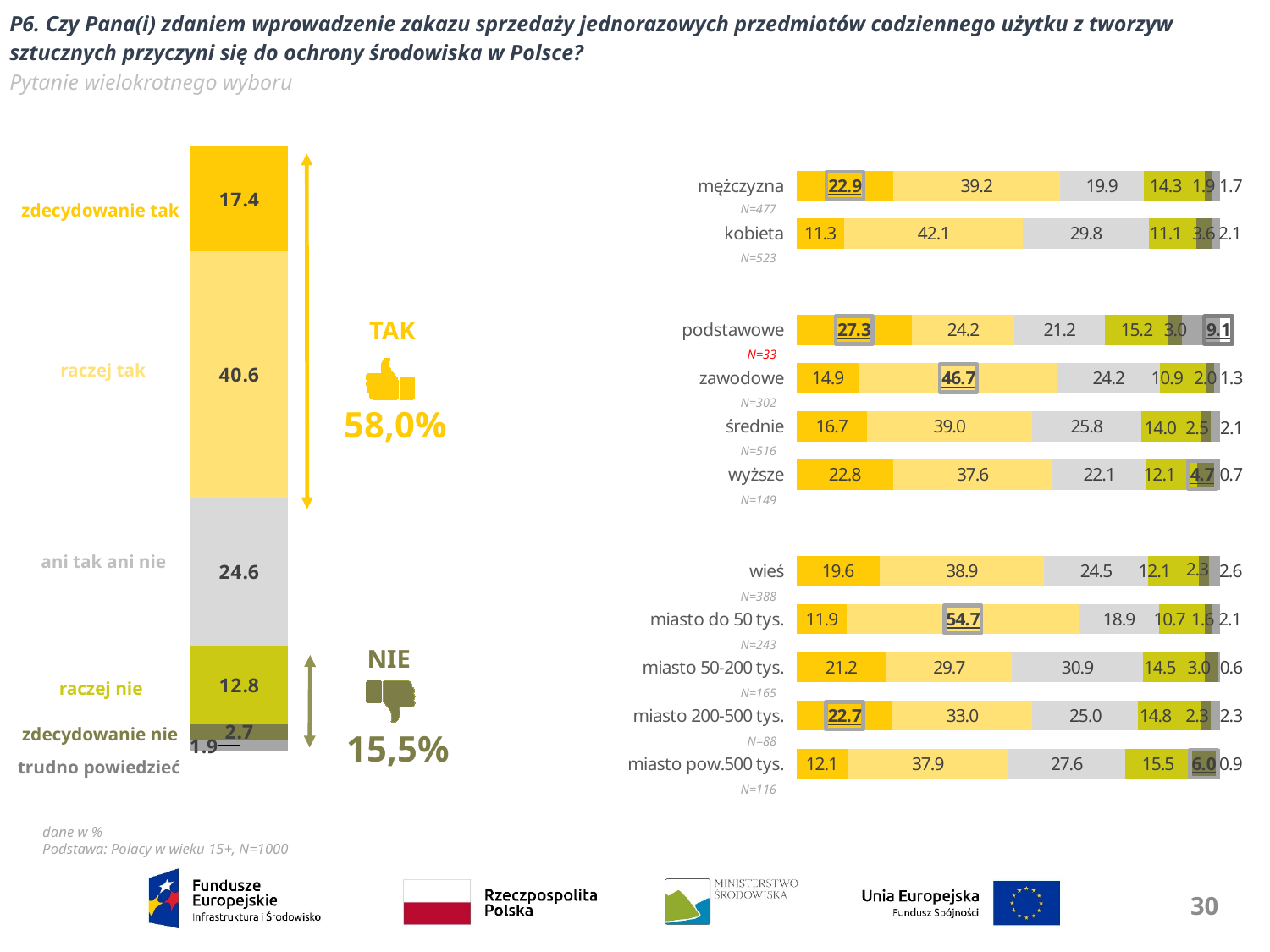
In the right chart of demographic groups, is the first (dark yellow) segment larger for 'mężczyzna' or 'kobieta'? mężczyzna In the right chart of demographic groups, what is the value of the first (dark yellow) segment for 'mężczyzna'? 22.9 In the left stacked bar chart, what is the difference between 'raczej tak' and 'zdecydowanie tak'? 23.2 In the left stacked bar chart, what combined percentage is shown next to the 'TAK' label? 58,0% How many demographic groups are shown in the right chart? 11 In the left stacked bar chart, what is the value for 'raczej tak'? 40.6 In the right chart of demographic groups, what is the value of the second (light yellow) segment for 'miasto do 50 tys.'? 54.7 In the right chart of demographic groups, which group has the highest value in the first (dark yellow) segment? podstawowe In the left stacked bar chart, which category has the highest value? raczej tak In the right chart of demographic groups, what is the difference between the grey (third) segment for 'kobieta' and for 'mężczyzna'? 9.9 In the left stacked bar chart, which category has the lowest value? trudno powiedzieć In the left stacked bar chart, what is the value for 'ani tak ani nie'? 24.6